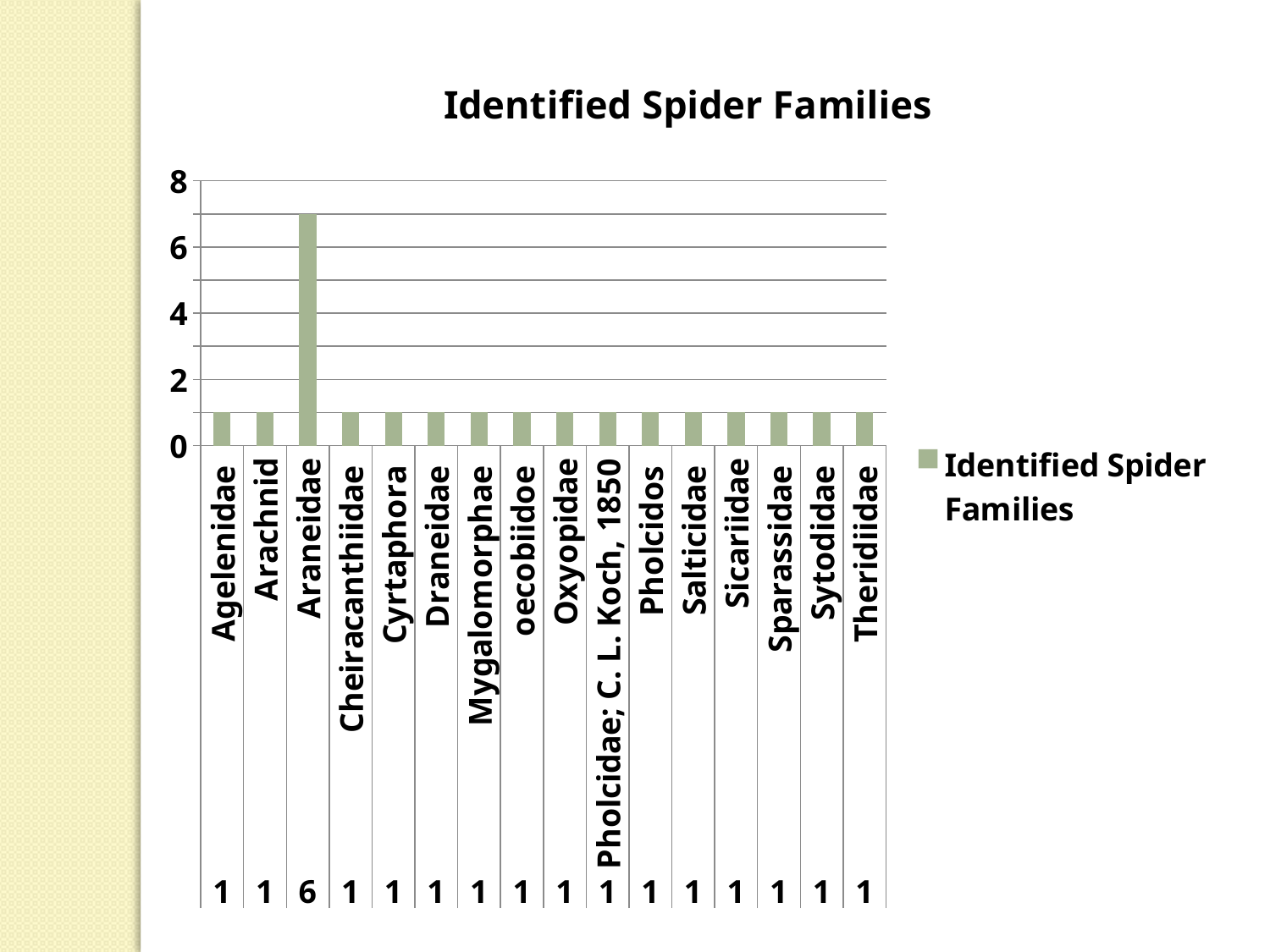
Is the value for Araneidae greater or less than 4? greater What is the value for Salticidae? 1 What type of chart is shown on the slide? bar chart What is the legend entry shown on the chart? Identified Spider Families What is the value for Araneidae according to the data table? 6 Which category has the highest value? Araneidae Is the value for Oxyopidae greater or less than 2? less What is the title of the chart? Identified Spider Families Which is larger, the value for Araneidae or the value for Sparassidae? Araneidae How many series does the legend list? 1 What is the value for Theridiidae? 1 How many spider family categories are shown on the x axis? 16